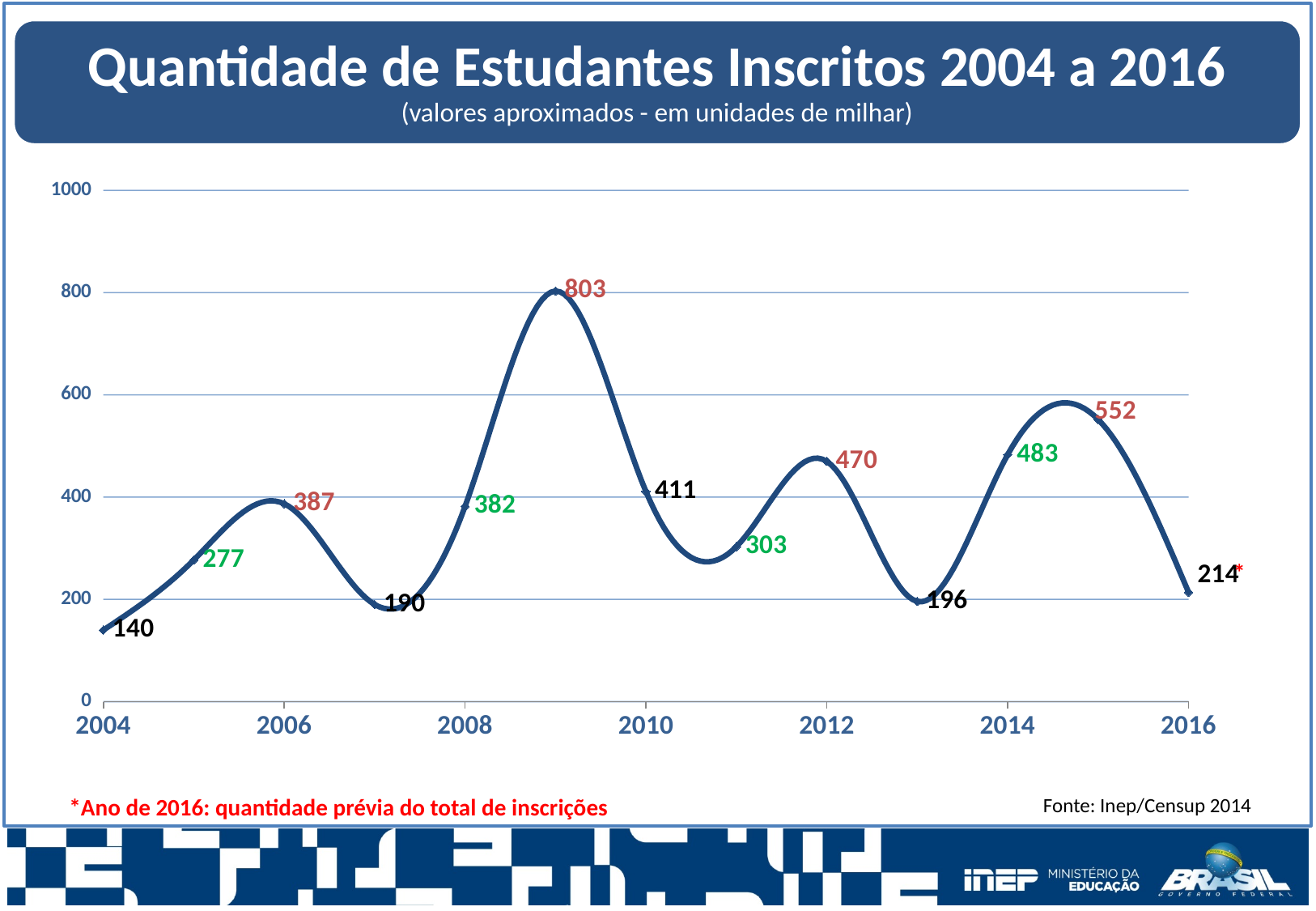
What is the value for 2012? 470 Which is larger, the value for 2006 or the value for 2008? 2006 What is the title of the chart? Quantidade de Estudantes Inscritos 2004 a 2016 What is the value for 2010? 411 Which year has the highest value? 2009 Which year has the lowest value? 2004 How many data points are plotted on the line? 13 What is the difference between the values for 2012 and 2010? 59 What is the value for 2004? 140 What is the value for 2016? 214 What kind of chart is shown? line chart Is the value for 2014 greater or less than 400? greater